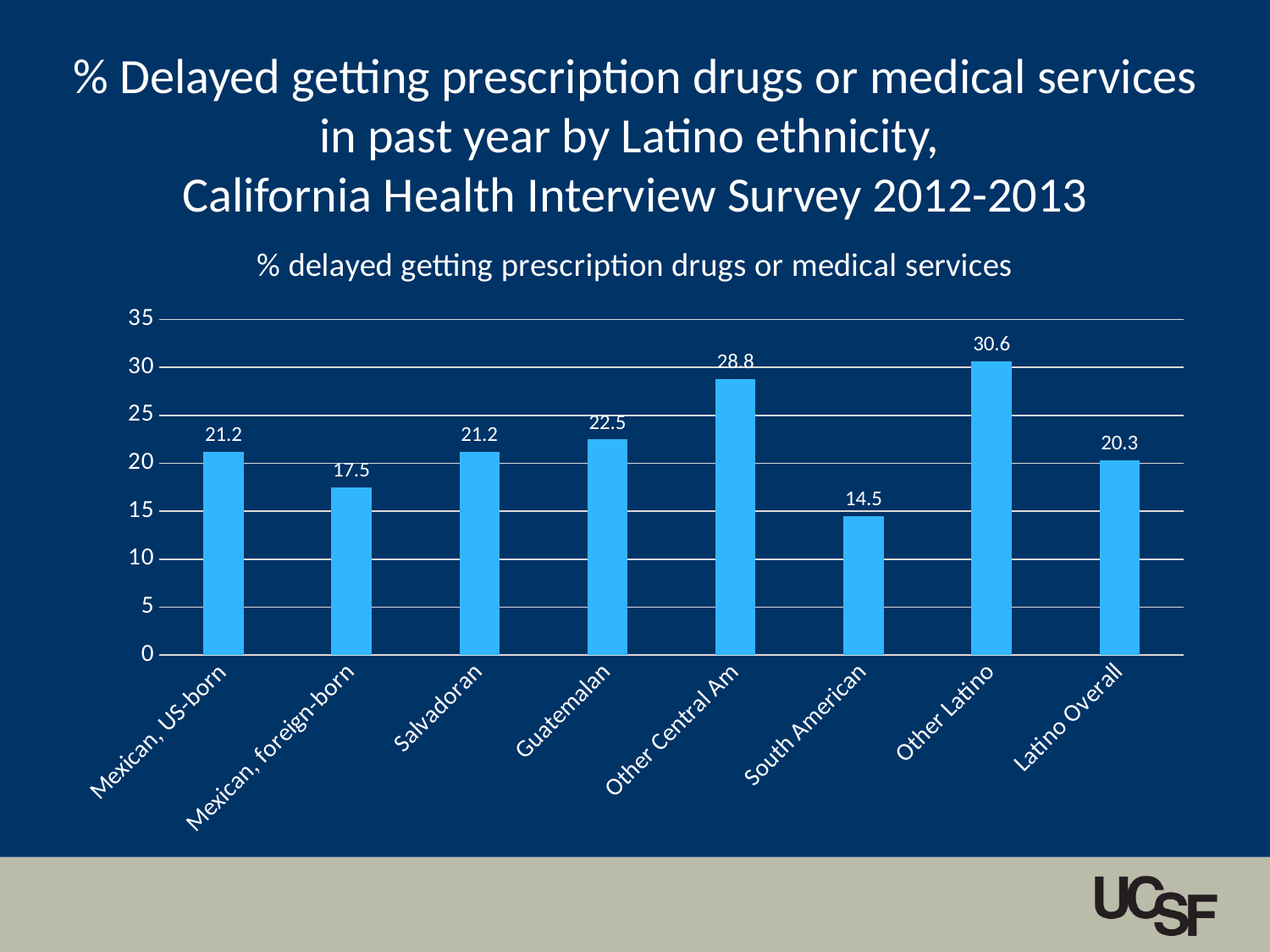
Is the value for Other Central Am greater or less than 25? greater What is the title of the chart? % delayed getting prescription drugs or medical services What is the value for Mexican, foreign-born? 17.5 Which category has the lowest value? South American What is the value for Other Latino? 30.6 Which is larger, the value for Salvadoran or the value for Mexican, foreign-born? Salvadoran What is the difference between the values for Other Central Am and Guatemalan? 6.3 What is the value for Latino Overall? 20.3 How many categories are shown on the x axis? 8 What kind of chart is shown on the slide? bar chart What is the value for South American? 14.5 Which category has the highest value? Other Latino